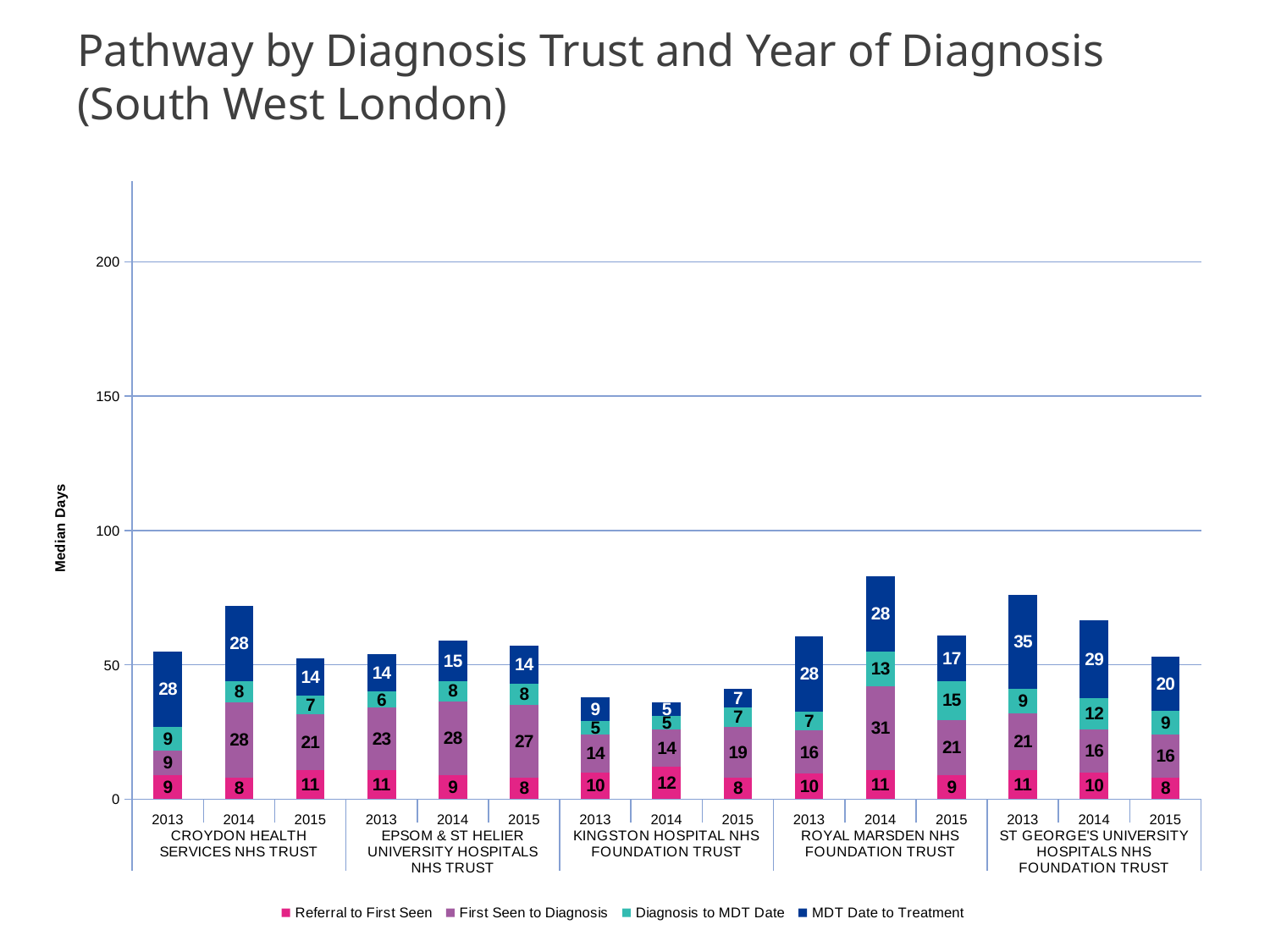
What is the total median days for the Kingston Hospital NHS Foundation Trust 2014 bar? 36 What kind of chart is shown on the slide? Stacked bar chart What is the difference between the MDT Date to Treatment values for St George's University Hospitals NHS Foundation Trust in 2013 and 2015? 15 What is the MDT Date to Treatment value for Royal Marsden NHS Foundation Trust in 2014? 28 Which trust and year has the tallest stacked bar? Royal Marsden NHS Foundation Trust, 2014 What is the First Seen to Diagnosis value for Epsom & St Helier University Hospitals NHS Trust in 2015? 27 Which trust and year has the shortest stacked bar? Kingston Hospital NHS Foundation Trust, 2014 What is the Diagnosis to MDT Date value for St George's University Hospitals NHS Foundation Trust in 2014? 12 What is the Referral to First Seen value for Kingston Hospital NHS Foundation Trust in 2014? 12 What is the total median days for the Royal Marsden NHS Foundation Trust 2014 bar? 83 Which is larger: the First Seen to Diagnosis value for Croydon Health Services NHS Trust in 2014 or in 2015? 2014 How many series does the legend list? 4